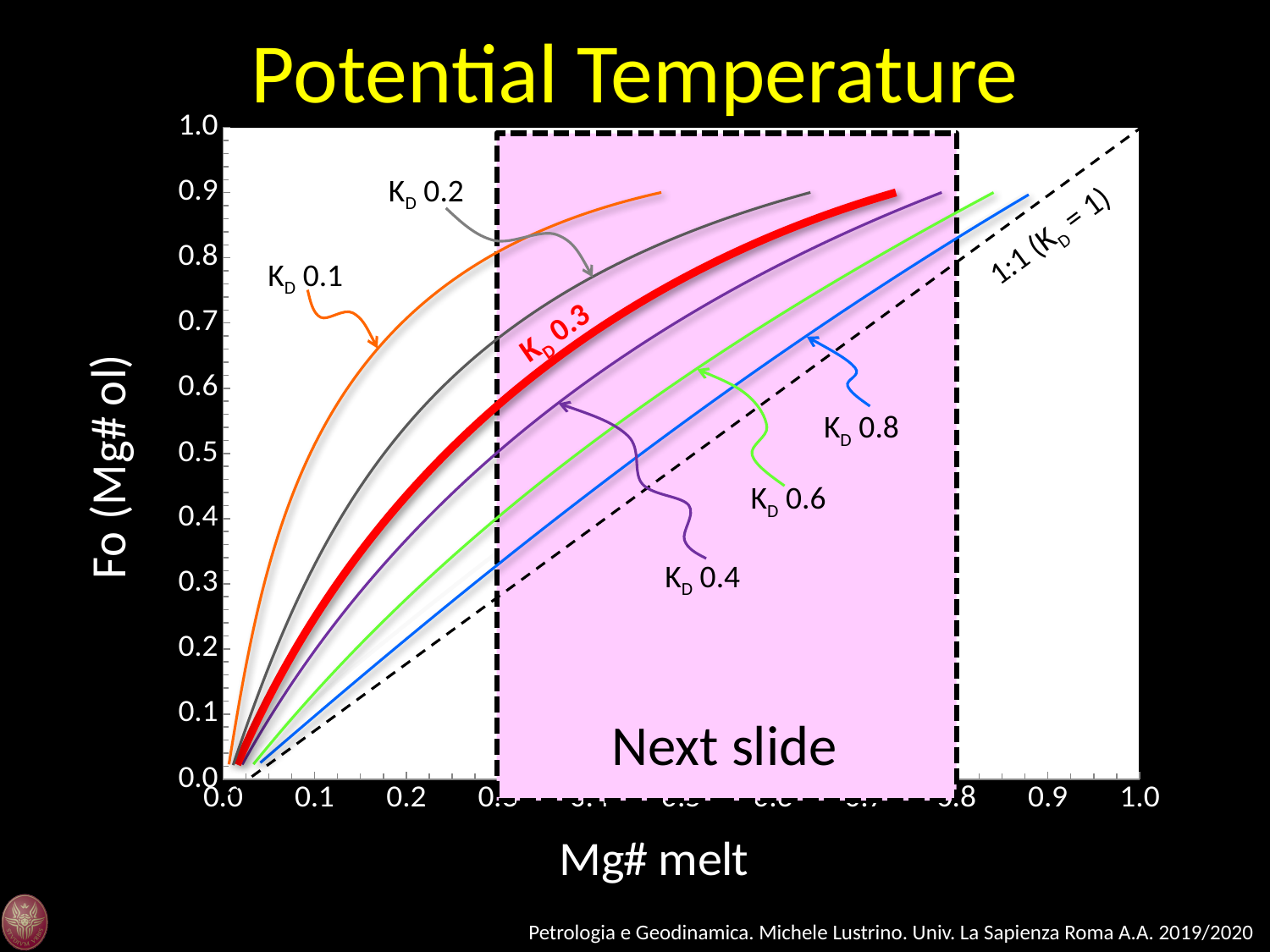
At Mg# melt 0.6, which curve gives a lower Fo value, KD 0.4 or KD 0.8? KD 0.8 What kind of chart is shown on the slide? line chart Which labelled KD curve lies closest to the 1:1 (KD = 1) dashed line? KD 0.8 How many labelled KD curves (excluding the 1:1 dashed line) are plotted? 6 Is the Fo value of the KD 0.2 curve at Mg# melt 0.3 greater or less than 0.6? greater Is the Fo value of the KD 0.1 curve at Mg# melt 0.2 greater or less than 0.6? greater At Mg# melt 0.4, which curve gives a higher Fo value, KD 0.2 or KD 0.6? KD 0.2 What is the title of the chart? Potential Temperature Do the curves rise or fall as Mg# melt increases along the x axis? rise What is the label of the y axis? Fo (Mg# ol) Which KD curve lies above all the others across the chart? KD 0.1 Is the Fo value of the KD 0.8 curve at Mg# melt 0.5 greater or less than 0.7? less